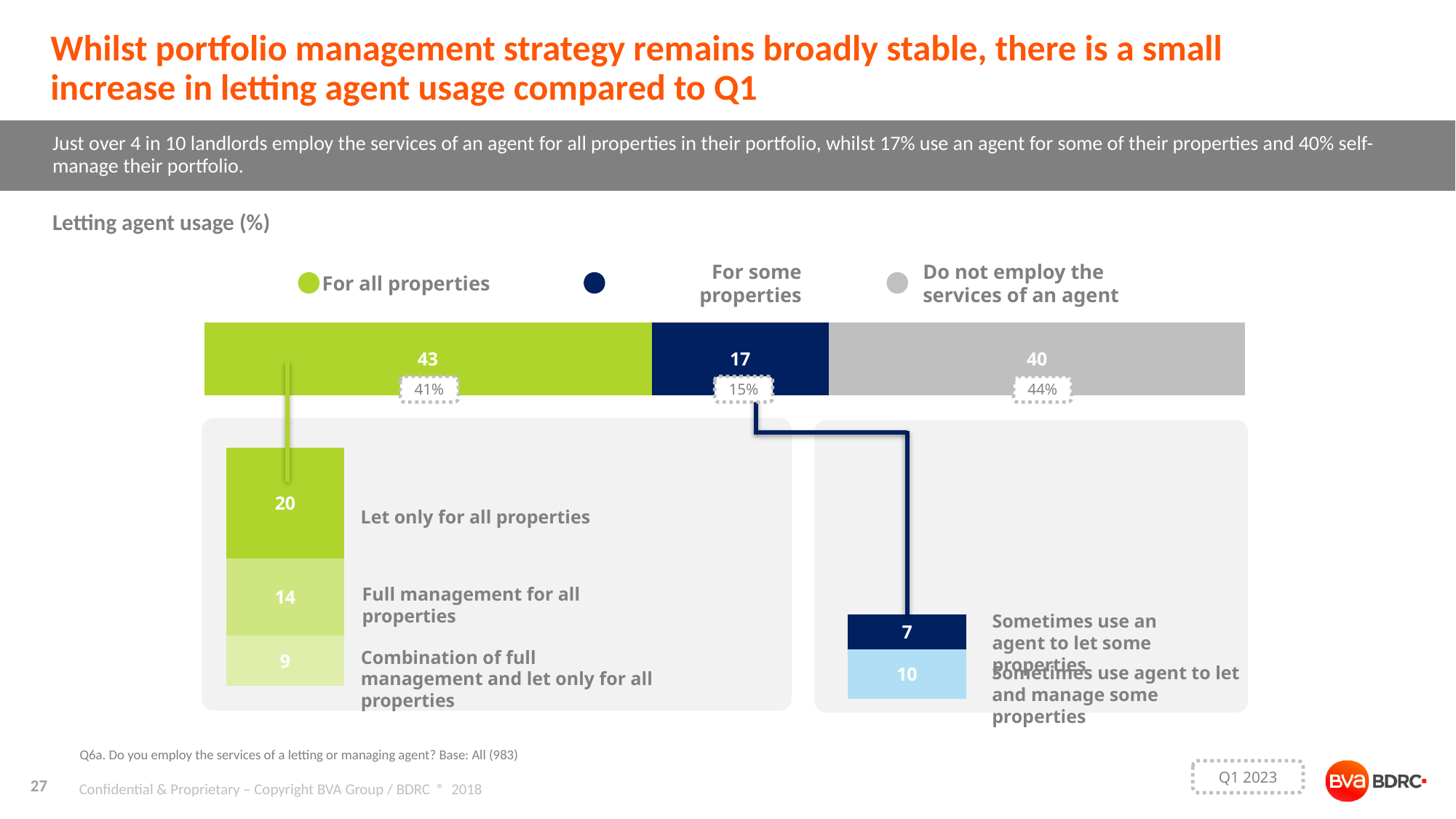
In the main stacked bar of the 'Letting agent usage (%)' chart, what is the value for 'Do not employ the services of an agent'? 40 How many entries does the legend of the 'Letting agent usage (%)' chart list? 3 In the main stacked bar of the 'Letting agent usage (%)' chart, what is the value for 'For some properties'? 17 In the 'Letting agent usage (%)' chart, what is the difference between the 'For all properties' value and the 'Do not employ the services of an agent' value in the main stacked bar? 3 In the 'Letting agent usage (%)' chart, what is the Q1 2023 value shown in the dashed box under the 'Do not employ the services of an agent' segment? 44% In the breakdown of 'For all properties' on the 'Letting agent usage (%)' chart, what is the value for 'Combination of full management and let only for all properties'? 9 In the breakdown of 'For some properties' on the 'Letting agent usage (%)' chart, which is larger: 'Sometimes use an agent to let some properties' or 'Sometimes use agent to let and manage some properties'? Sometimes use agent to let and manage some properties In the 'Letting agent usage (%)' chart, which segment of the main stacked bar has the highest value? For all properties In the 'Letting agent usage (%)' chart, which segment of the main stacked bar has the lowest value? For some properties In the 'Letting agent usage (%)' chart, what is the Q1 2023 value shown in the dashed box under the 'For some properties' segment? 15% In the breakdown of 'For all properties' on the 'Letting agent usage (%)' chart, what is the value for 'Let only for all properties'? 20 In the main stacked bar of the 'Letting agent usage (%)' chart, what is the value for 'For all properties'? 43